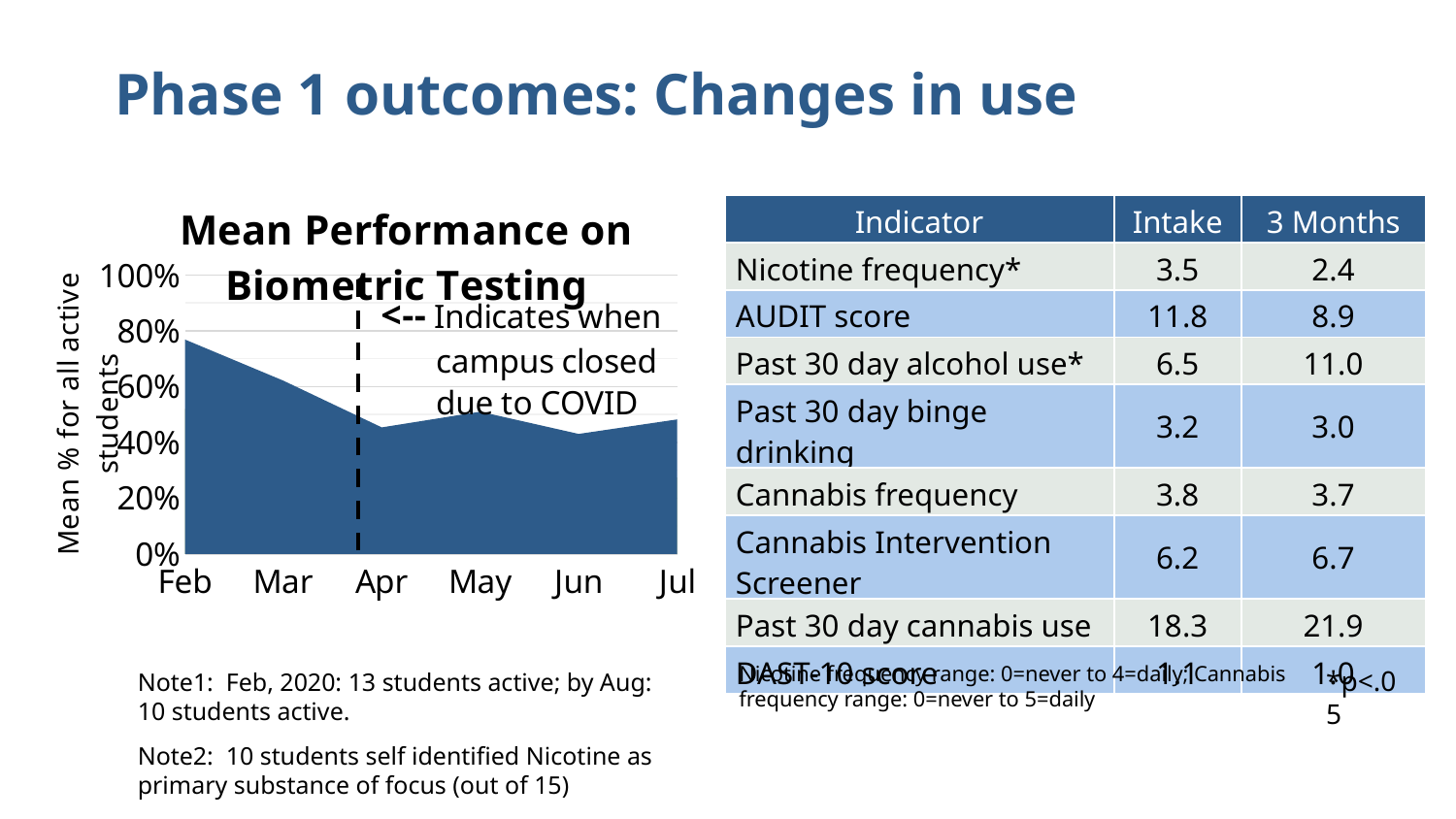
Which is larger, the value for Feb or the value for Jul? Feb What is the title of the chart? Mean Performance on Biometric Testing Which is larger, the value for Mar or the value for Apr? Mar How many months are plotted along the x axis of the chart? 6 Is the value for Apr greater or less than 60%? less Does the mean performance rise or fall from Feb to Apr? Fall Which month has the highest mean performance on biometric testing? Feb Is the value for Jul greater or less than 60%? less Is the value for Feb greater or less than 60%? greater According to the annotation on the chart, what does the dashed vertical line indicate? When campus closed due to COVID What type of chart is shown on the slide? Area chart